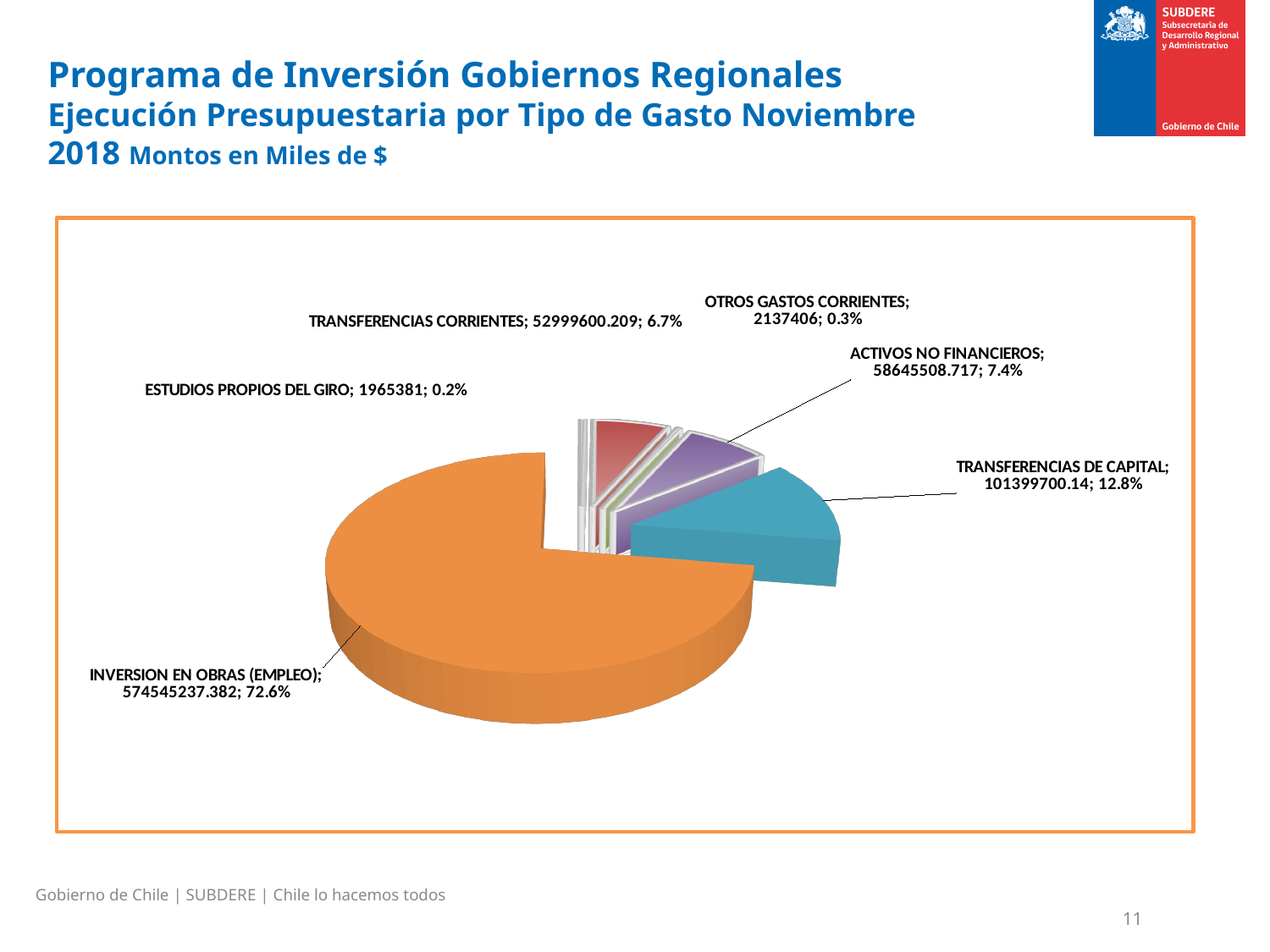
In what unit are the amounts in the chart expressed, according to the slide title? Miles de $ What is the value shown for OTROS GASTOS CORRIENTES? 2137406 What share of the pie does INVERSION EN OBRAS (EMPLEO) represent? 72.6% What is the value shown for TRANSFERENCIAS DE CAPITAL? 101399700.14 Which category has the largest slice of the pie? INVERSION EN OBRAS (EMPLEO) What is the difference in percentage share between TRANSFERENCIAS DE CAPITAL (12.8%) and ACTIVOS NO FINANCIEROS (7.4%)? 5.4% How many slices (categories) does the pie chart have? 6 Which category has the smallest slice of the pie? ESTUDIOS PROPIOS DEL GIRO Which is larger, the value for TRANSFERENCIAS DE CAPITAL or the value for ACTIVOS NO FINANCIEROS? TRANSFERENCIAS DE CAPITAL What is the value shown for ACTIVOS NO FINANCIEROS? 58645508.717 What kind of chart is shown on the slide? Pie chart What share of the pie does TRANSFERENCIAS CORRIENTES represent? 6.7%